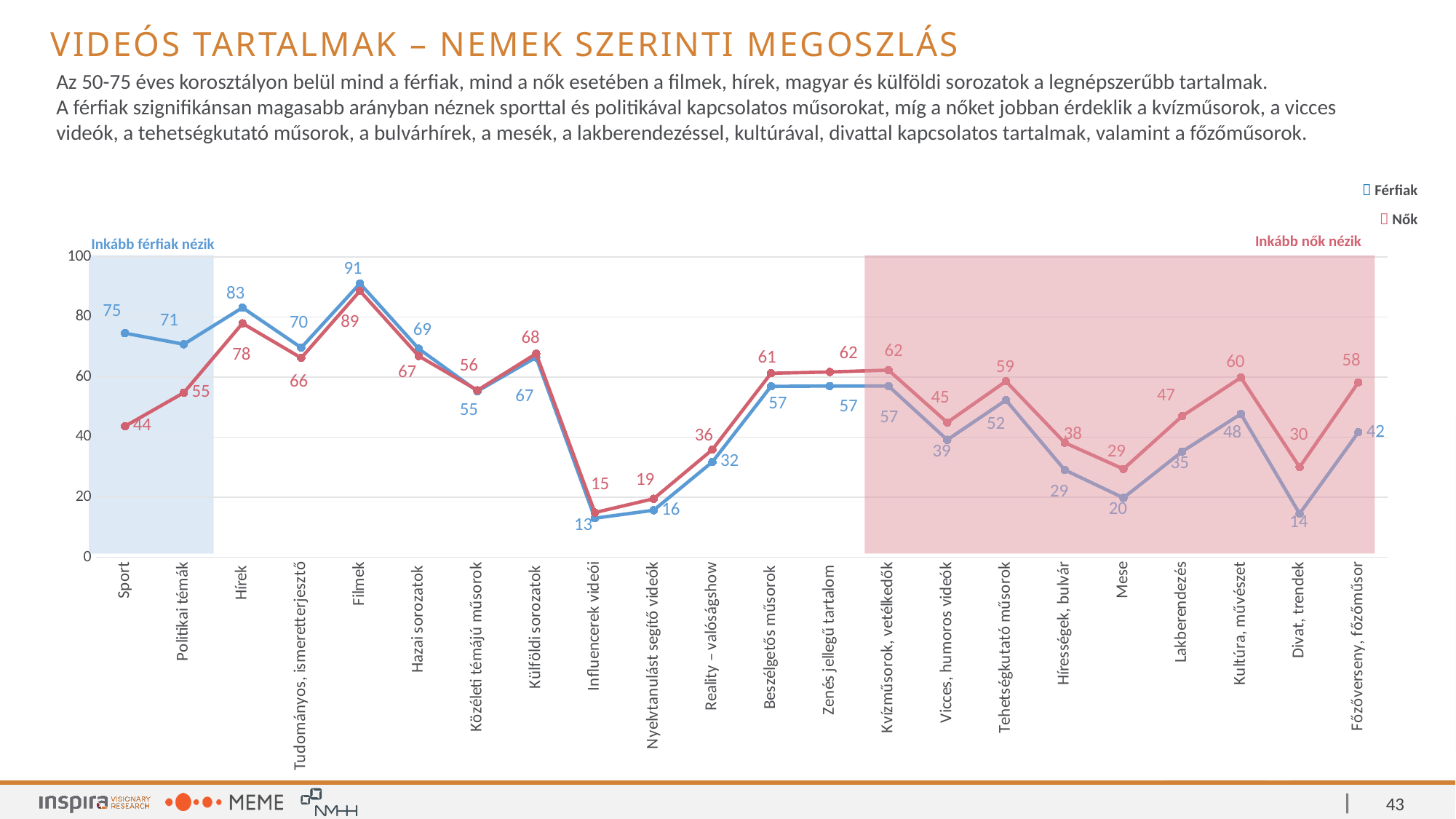
Which is larger for Lakberendezés, the Férfiak value or the Nők value? Nők What is the value for Férfiak for Sport? 75 What is the value for Nők for Divat, trendek? 30 What colour is the line for the Nők series? red How many categories are plotted along the x axis? 22 How many series does the legend list? 2 What is the value for Férfiak for Mese? 20 Which category has the highest value for Férfiak? Filmek What is the difference between the Nők and Férfiak values for Kultúra, művészet? 12 What is the difference between the Férfiak and Nők values for Sport? 31 What type of chart is shown on the slide? line chart Which category has the lowest value for Nők? Influencerek videói